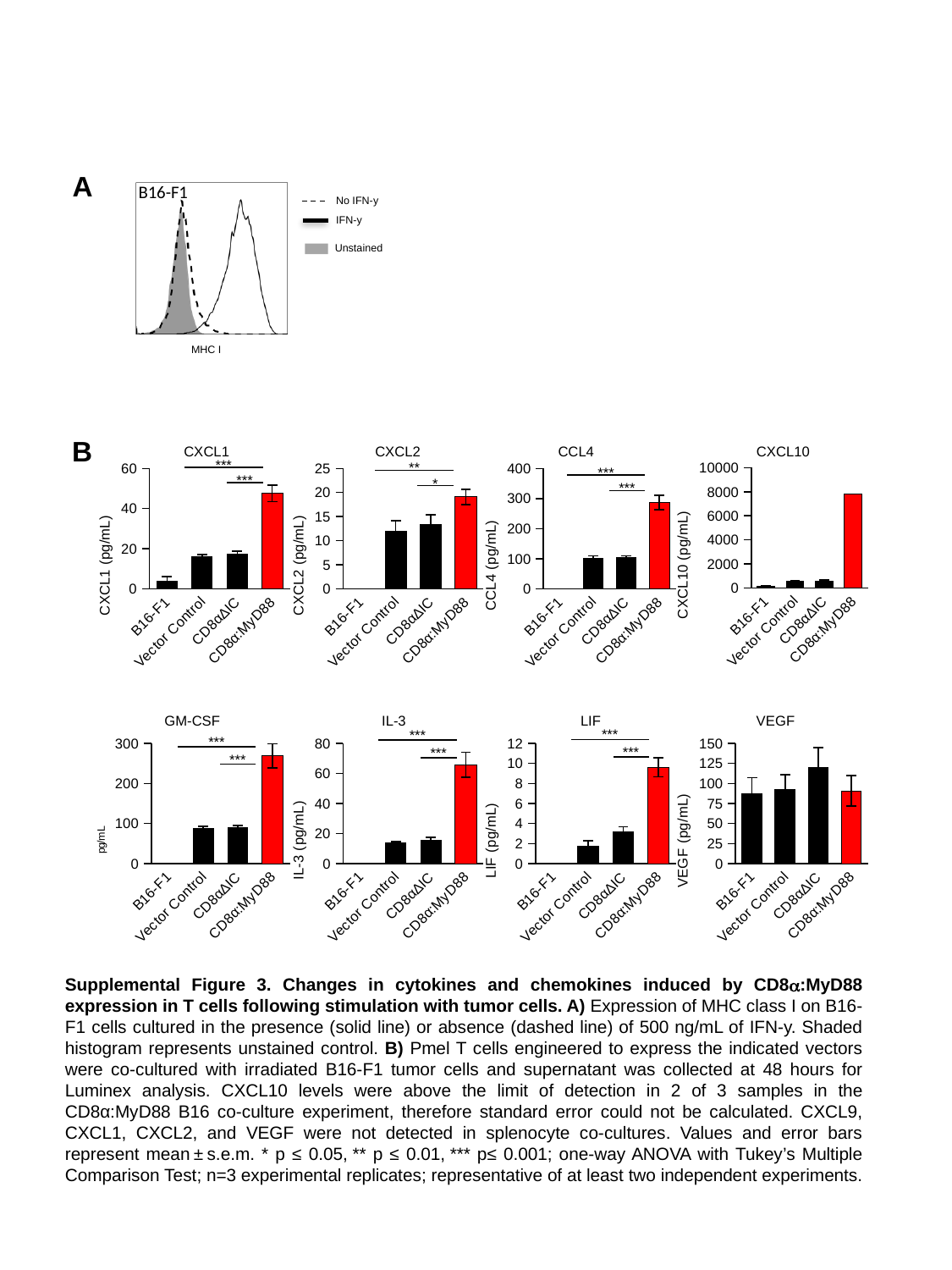
How many categories are shown on the x axis of the IL-3 chart? 4 In the VEGF chart, which category has the highest value? CD8αΔIC In the LIF chart, which is larger, the value for Vector Control or the value for CD8αΔIC? CD8αΔIC In the CXCL2 chart, is the value for CD8α:MyD88 greater or less than 15? greater In the CXCL1 chart, is the value for CD8α:MyD88 greater or less than 40? greater In the CCL4 chart, is the value for CD8α:MyD88 greater or less than 200? greater What kind of chart is the CCL4 chart? bar chart In the CXCL1 chart, which category has the highest value? CD8α:MyD88 How many entries does the legend of the B16-F1 histogram in panel A list? 3 In the CXCL1 chart, which category has the lowest value? B16-F1